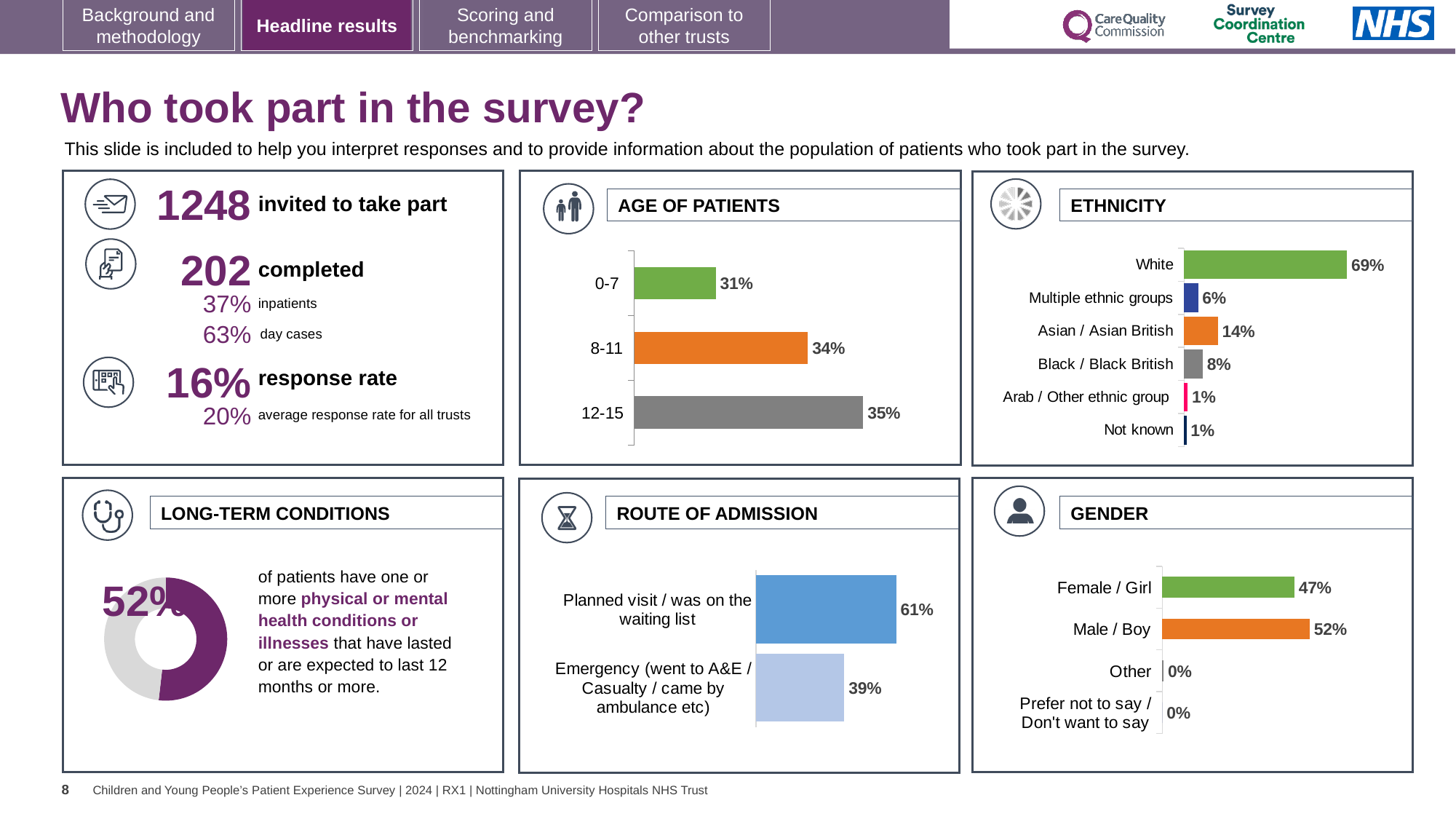
What type of chart is used in the LONG-TERM CONDITIONS panel? Doughnut chart In the GENDER chart, which category has the lowest percentage, Other or Male / Boy? Other In the ETHNICITY chart, what percentage of patients were White? 69% How many ethnicity categories are shown in the ETHNICITY chart? 6 In the ROUTE OF ADMISSION chart, which route has the larger percentage: Planned visit / was on the waiting list or Emergency? Planned visit / was on the waiting list In the AGE OF PATIENTS chart, which age group has the highest percentage? 12-15 What type of chart is the AGE OF PATIENTS chart? Bar chart In the GENDER chart, what is the difference between the Male / Boy and Female / Girl percentages? 5% In the ETHNICITY chart, what is the difference between the Asian / Asian British and Black / Black British percentages? 6% In the AGE OF PATIENTS chart, what percentage of patients were aged 8-11? 34% In the ROUTE OF ADMISSION chart, what percentage of patients came via Emergency (went to A&E / Casualty / came by ambulance etc)? 39% In the GENDER chart, what percentage of patients were Male / Boy? 52%